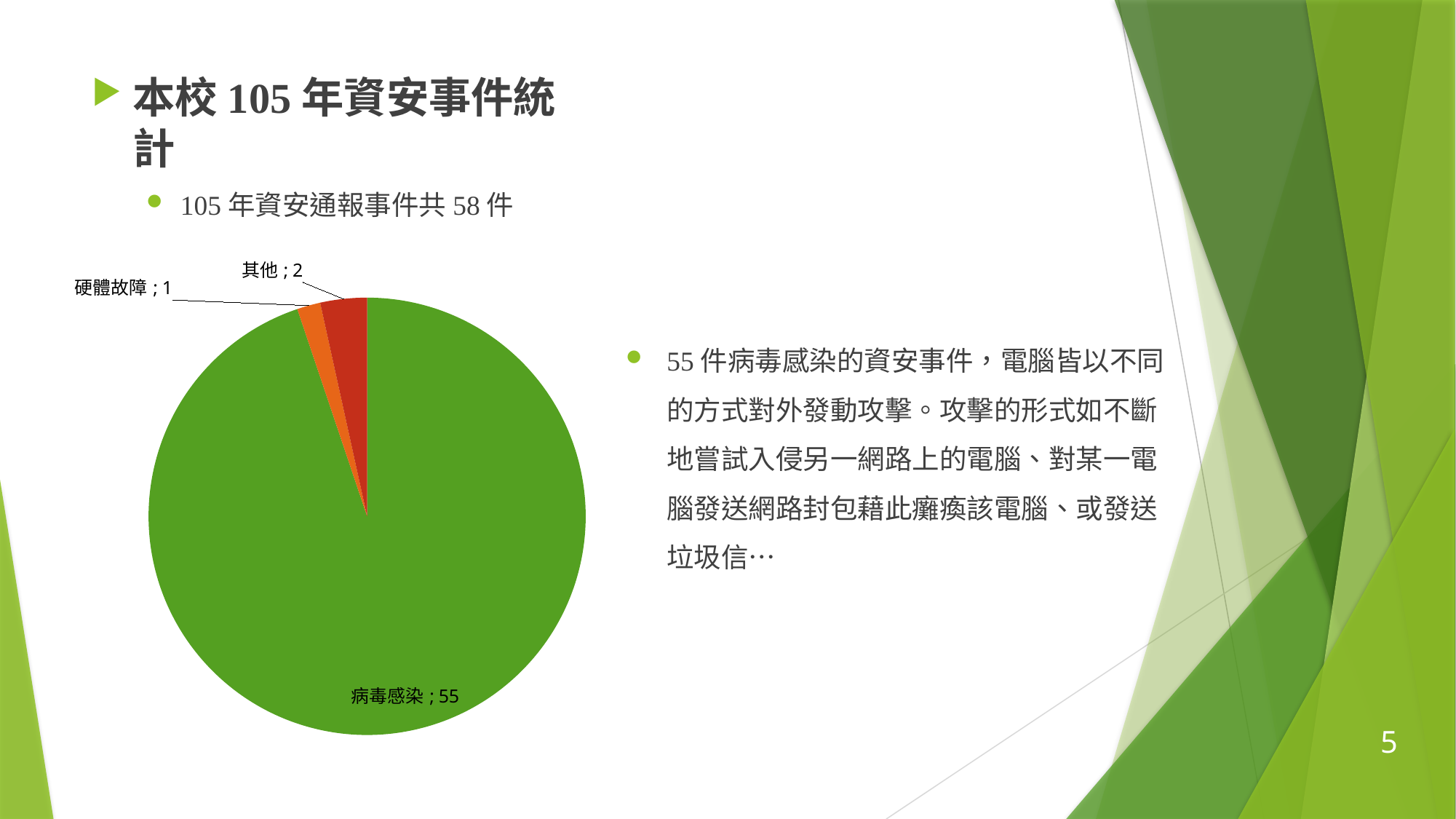
Which is larger, the value for 其他 or the value for 硬體故障? 其他 Which category has the smallest slice in the pie chart? 硬體故障 What is the total of all slices in the pie chart? 58 How many slices does the pie chart have? 3 What type of chart is shown on the slide? pie chart What is the value for 硬體故障 in the pie chart? 1 What is the difference between the values for 其他 and 硬體故障? 1 What is the difference between the values for 病毒感染 and 其他? 53 What colour is the 病毒感染 slice in the pie chart? green What is the value for 病毒感染 in the pie chart? 55 Which category has the largest slice in the pie chart? 病毒感染 What is the value for 其他 in the pie chart? 2